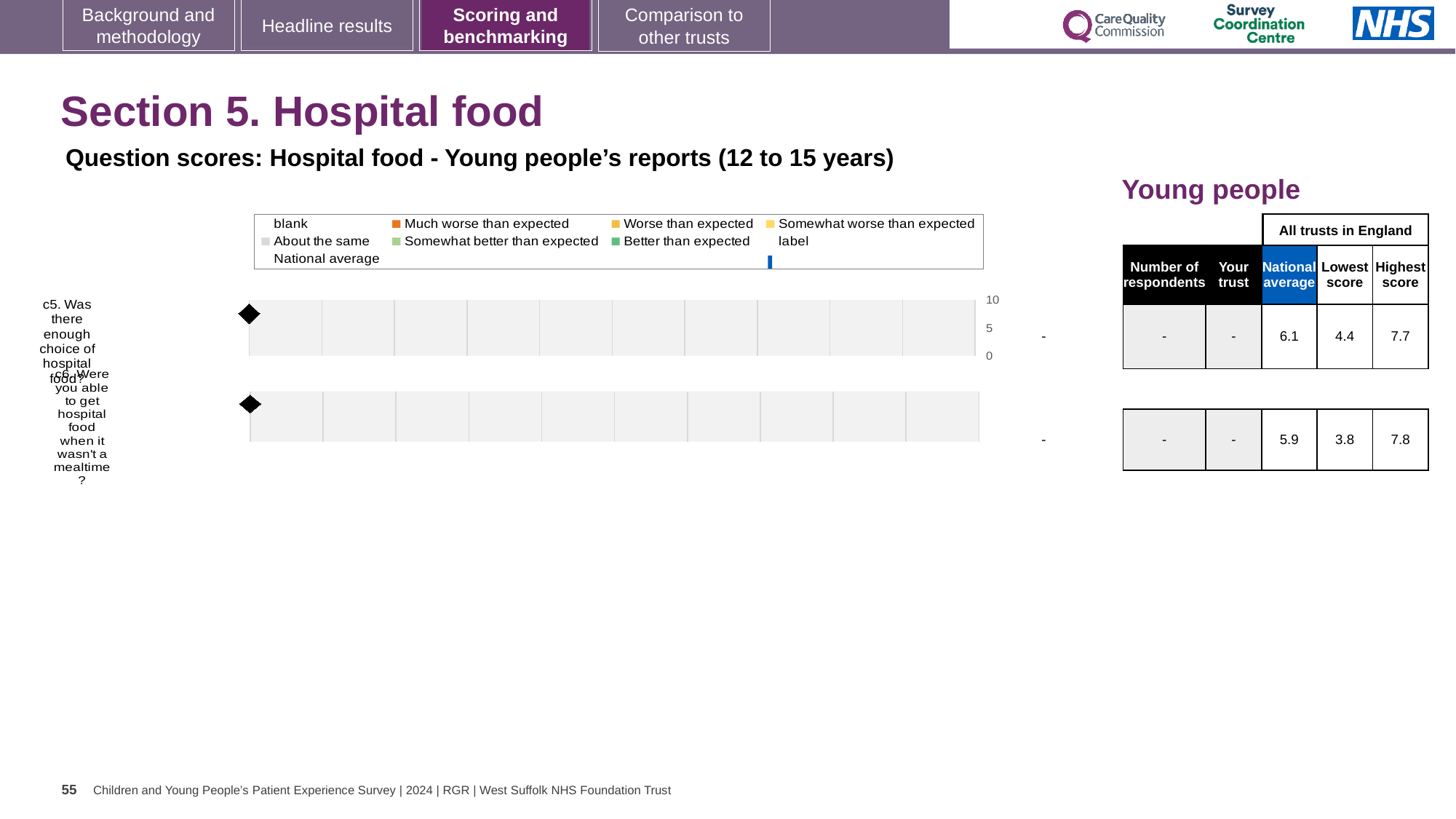
What is the highest score across all trusts in England for question c6? 7.8 Which question has the lower lowest score across all trusts in England? c6 What is the difference between the highest and lowest trust scores for question c6? 4.0 Which question has the higher national average score, c5 or c6? c5 What is shown in the 'Your trust' column of the table for both questions? - What is the national average score for question c5 (Was there enough choice of hospital food?) in the table? 6.1 What type of chart is used to show the question scores for hospital food? bar chart What is the difference between the highest and lowest trust scores for question c5? 3.3 What is the lowest score across all trusts in England for question c5? 4.4 What is the highest value shown on the chart's score axis? 10 What is the national average score for question c6 (Were you able to get hospital food when it wasn't a mealtime?) in the table? 5.9 How many questions (categories) are plotted on the chart? 2